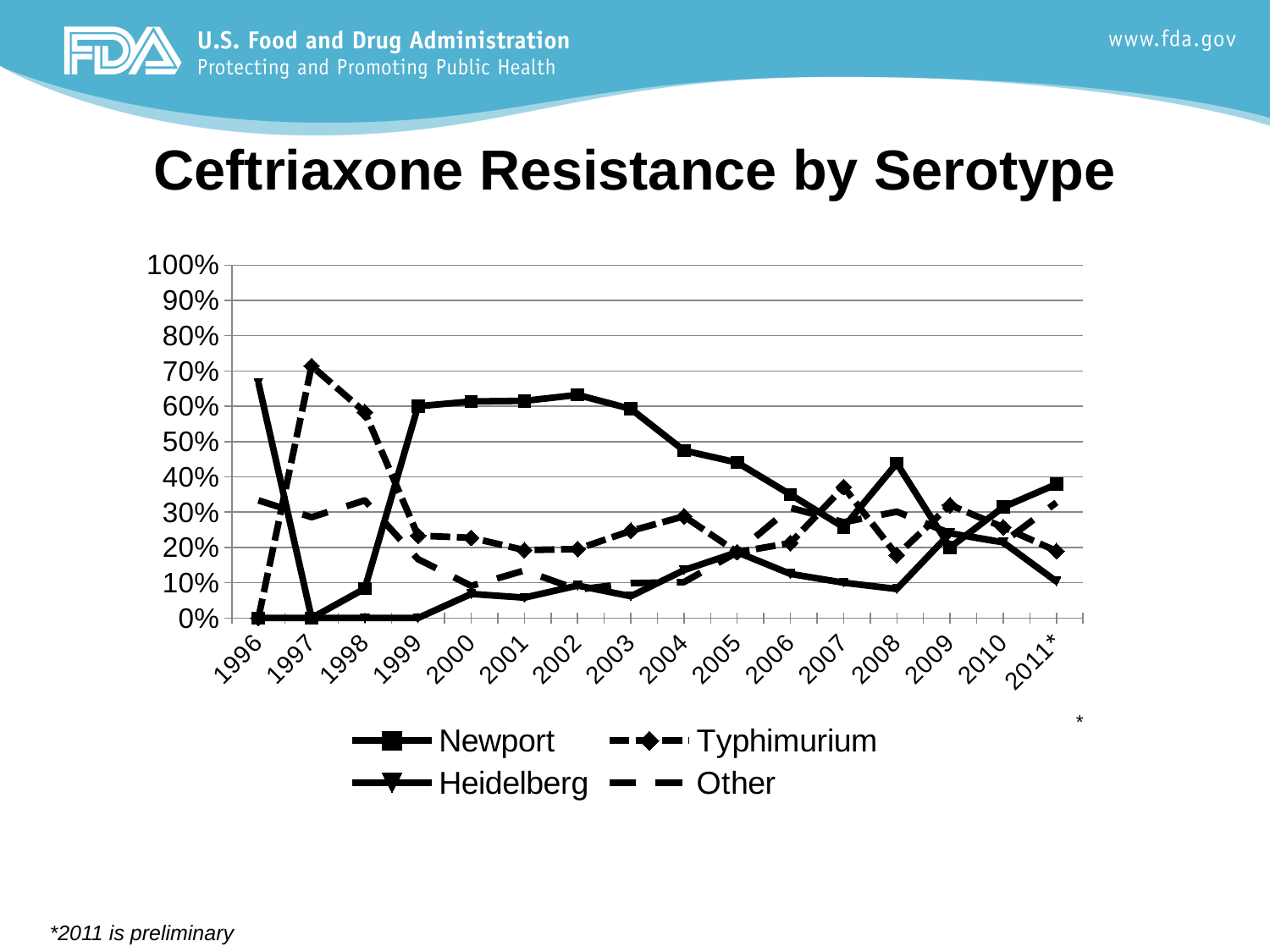
Is the value for Heidelberg in 1996 greater or less than 60%? greater How many series does the legend list? 4 Which serotype has the lowest ceftriaxone resistance in 1999? Heidelberg Is the value for Newport in 2002 greater or less than 50%? greater Which serotype has the highest ceftriaxone resistance in 1997? Typhimurium Does the Newport line rise or fall between 2002 and 2007? fall Is the value for Other in 2004 greater or less than 20%? less In 2008, which is larger: the value for Newport or the value for Typhimurium? Newport How many years are shown along the x axis? 16 What kind of chart is shown on the slide? line chart Which serotype has the highest ceftriaxone resistance in 2002? Newport